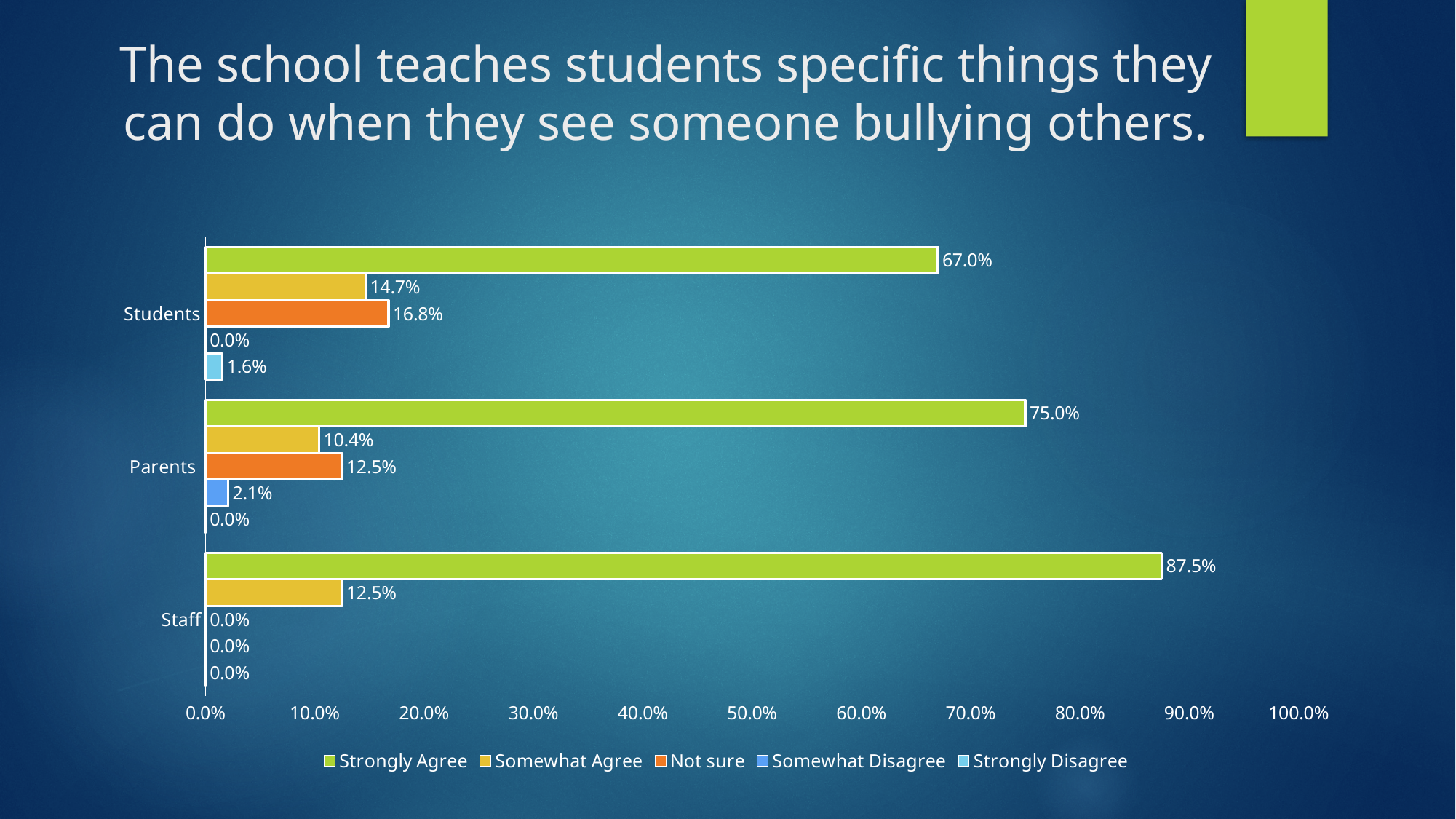
Which is larger for Students: Somewhat Agree or Not sure? Not sure Which group has the highest Strongly Agree value? Staff How many groups are shown on the y axis? 3 What is the Somewhat Agree value for Staff? 12.5% What colour are the Strongly Agree bars? Green What is the difference between the Strongly Agree values for Staff and Students? 20.5% What is the Strongly Agree value for Students? 67.0% What is the Strongly Disagree value for Students? 1.6% How many series does the legend list? 5 Which group has the lowest Somewhat Agree value? Parents What is the Not sure value for Parents? 12.5% What kind of chart is shown on the slide? Bar chart